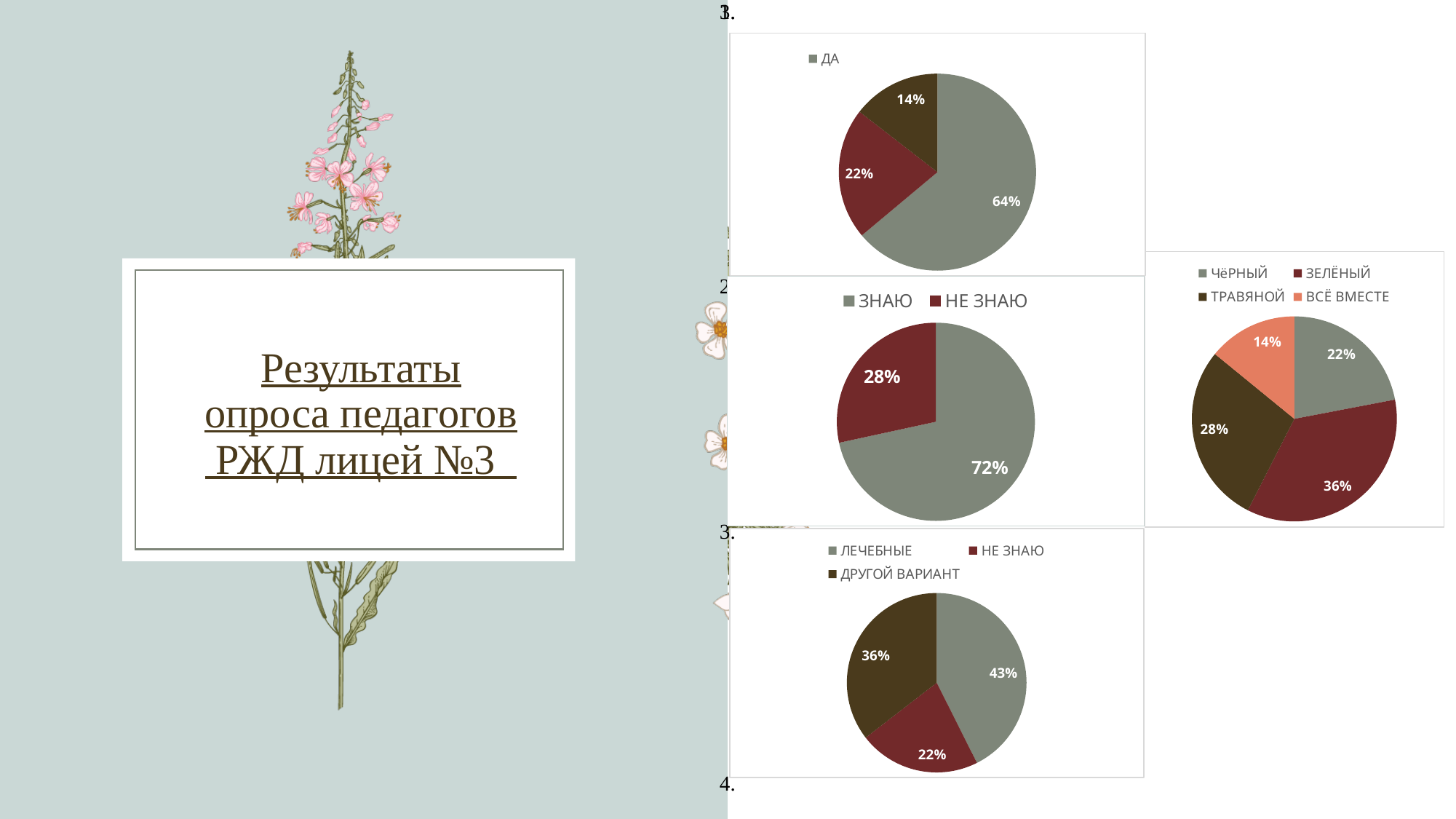
In the pie chart in the middle of the right column (legend ЗНАЮ / НЕ ЗНАЮ), how many series does the legend list? 2 In the pie chart on the far right (legend ЧёРНЫЙ, ЗЕЛЁНЫЙ, ТРАВЯНОЙ, ВСЁ ВМЕСТЕ), which category has the largest share? ЗЕЛЁНЫЙ In the bottom pie chart of the right column (legend ЛЕЧЕБНЫЕ, НЕ ЗНАЮ, ДРУГОЙ ВАРИАНТ), what share is ЛЕЧЕБНЫЕ? 43% In the pie chart on the far right (legend ЧёРНЫЙ, ЗЕЛЁНЫЙ, ТРАВЯНОЙ, ВСЁ ВМЕСТЕ), how many slices does the pie have? 4 In the pie chart in the middle of the right column (legend ЗНАЮ / НЕ ЗНАЮ), what share is labelled ЗНАЮ? 72% In the pie chart on the far right (legend ЧёРНЫЙ, ЗЕЛЁНЫЙ, ТРАВЯНОЙ, ВСЁ ВМЕСТЕ), what is the difference between the ТРАВЯНОЙ share and the ЧёРНЫЙ share? 6% In the top pie chart of the right column (legend entry ДА), what share is labelled on the largest slice? 64% What type of chart is the top chart in the right column? Pie chart In the pie chart on the far right (legend ЧёРНЫЙ, ЗЕЛЁНЫЙ, ТРАВЯНОЙ, ВСЁ ВМЕСТЕ), what share is ЗЕЛЁНЫЙ? 36% In the pie chart on the far right (legend ЧёРНЫЙ, ЗЕЛЁНЫЙ, ТРАВЯНОЙ, ВСЁ ВМЕСТЕ), which category has the smallest share? ВСЁ ВМЕСТЕ In the pie chart in the middle of the right column (legend ЗНАЮ / НЕ ЗНАЮ), what share is labelled НЕ ЗНАЮ? 28% In the bottom pie chart of the right column (legend ЛЕЧЕБНЫЕ, НЕ ЗНАЮ, ДРУГОЙ ВАРИАНТ), which is larger: ДРУГОЙ ВАРИАНТ or НЕ ЗНАЮ? ДРУГОЙ ВАРИАНТ